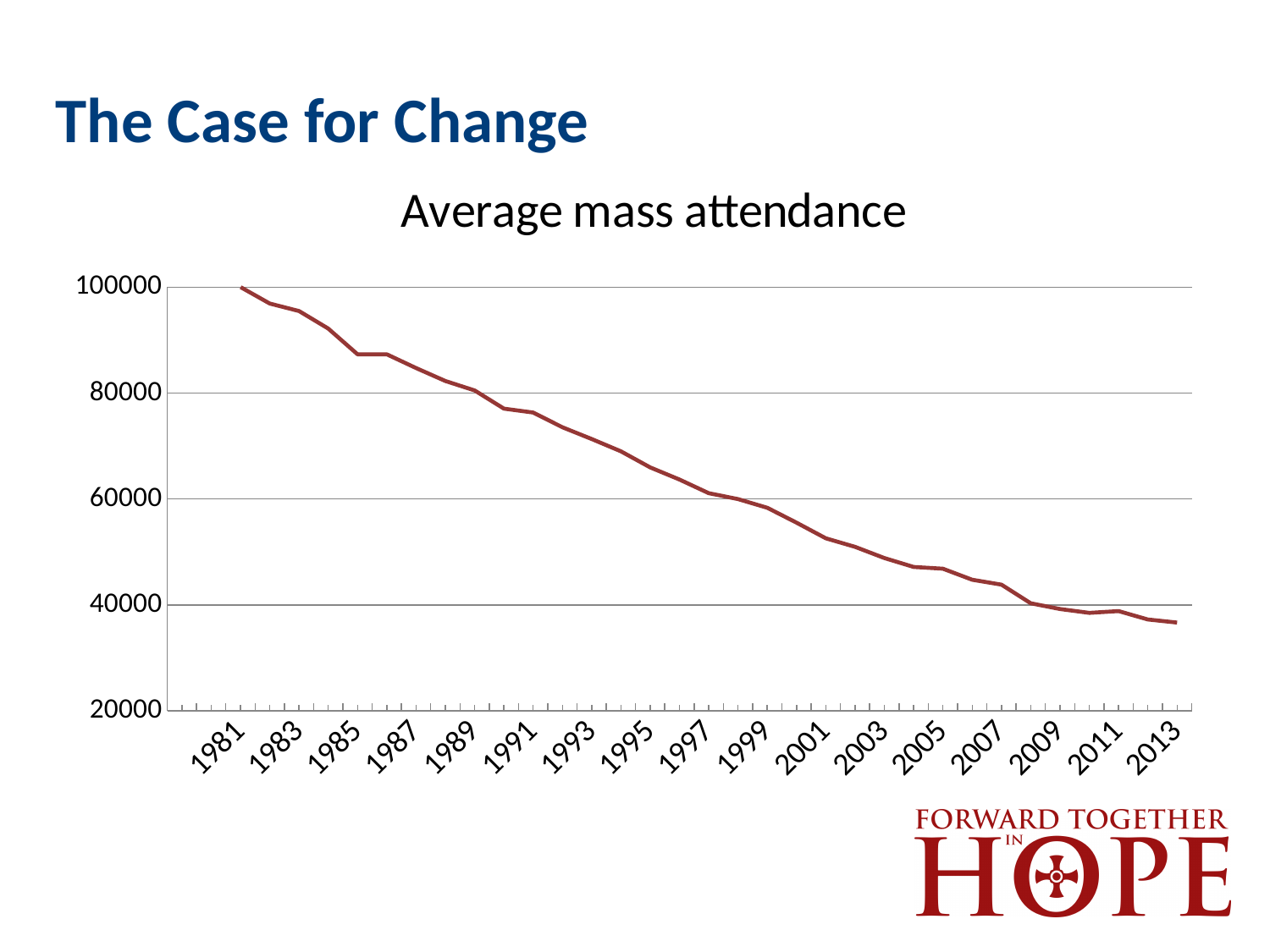
Is the value for 1991 greater or less than 80000? less Is the value for 1993 greater or less than 60000? greater Which year has the lowest average mass attendance? 2013 What kind of chart is shown on the slide? line chart Which year has the highest average mass attendance? 1981 Is the value for 2013 greater or less than 40000? less What is the title of the chart? Average mass attendance Which is larger, the value for 1985 or the value for 2005? 1985 Do the values rise or fall from 1981 to 2013? fall What is the first year labelled on the x axis? 1981